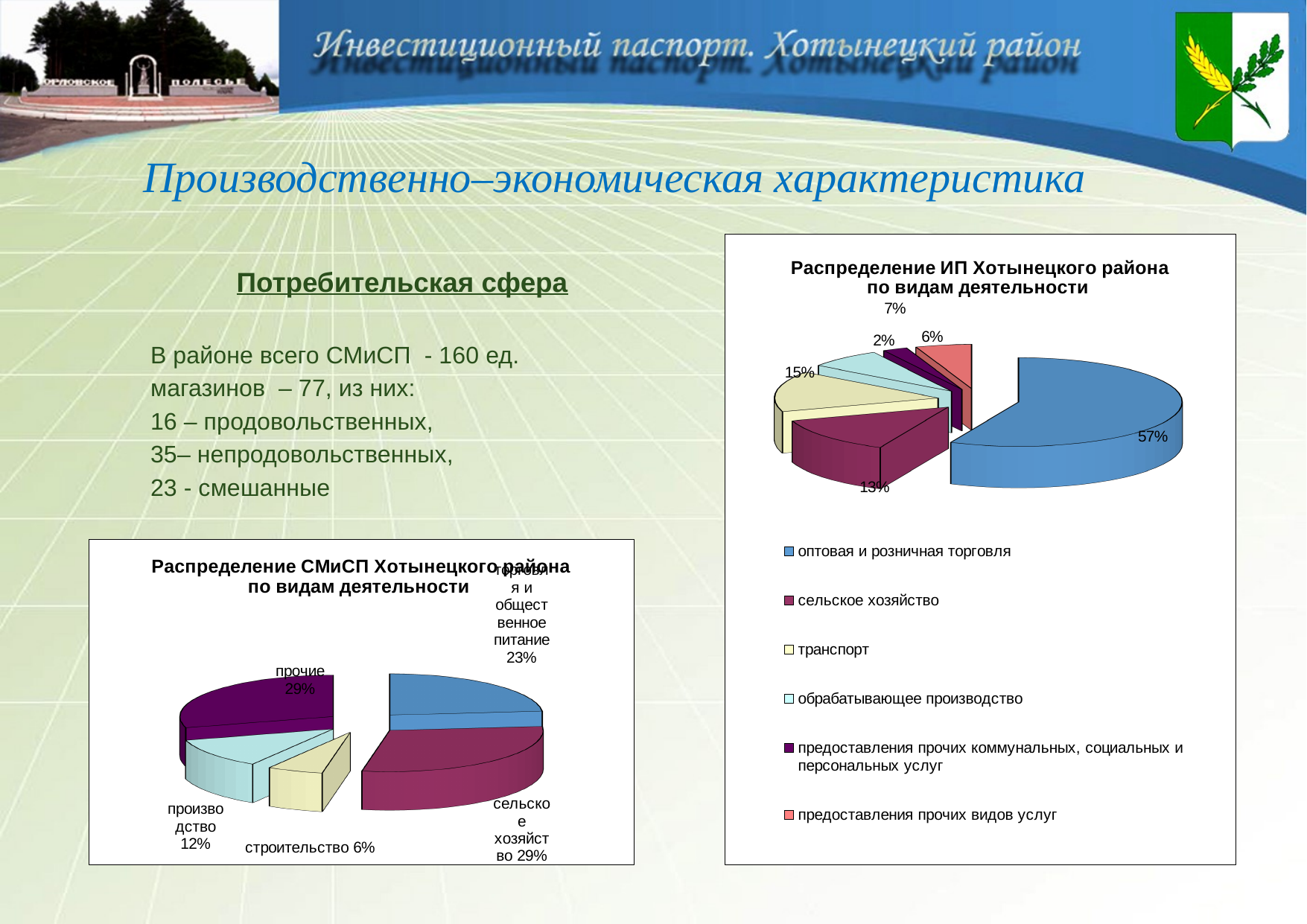
What type of chart is 'Распределение СМиСП Хотынецкого района по видам деятельности'? Pie chart In the chart 'Распределение СМиСП Хотынецкого района по видам деятельности', which category has the smallest share? строительство In the chart 'Распределение ИП Хотынецкого района по видам деятельности', how many categories does the legend list? 6 In the chart 'Распределение СМиСП Хотынецкого района по видам деятельности', what share does 'торговля и общественное питание' have? 23% In the chart 'Распределение ИП Хотынецкого района по видам деятельности', what share does 'транспорт' have? 15% In the chart 'Распределение СМиСП Хотынецкого района по видам деятельности', what share does 'строительство' have? 6% In the chart 'Распределение ИП Хотынецкого района по видам деятельности', what colour is the slice for 'сельское хозяйство'? Maroon (dark red) In the chart 'Распределение СМиСП Хотынецкого района по видам деятельности', what is the difference between the shares of 'прочие' and 'производство'? 17% In the chart 'Распределение ИП Хотынецкого района по видам деятельности', which is larger: the share of 'сельское хозяйство' or 'транспорт'? транспорт In the chart 'Распределение ИП Хотынецкого района по видам деятельности', which category has the largest share? оптовая и розничная торговля In the chart 'Распределение СМиСП Хотынецкого района по видам деятельности', how many slices does the pie have? 5 In the chart 'Распределение ИП Хотынецкого района по видам деятельности', what share does 'оптовая и розничная торговля' have? 57%